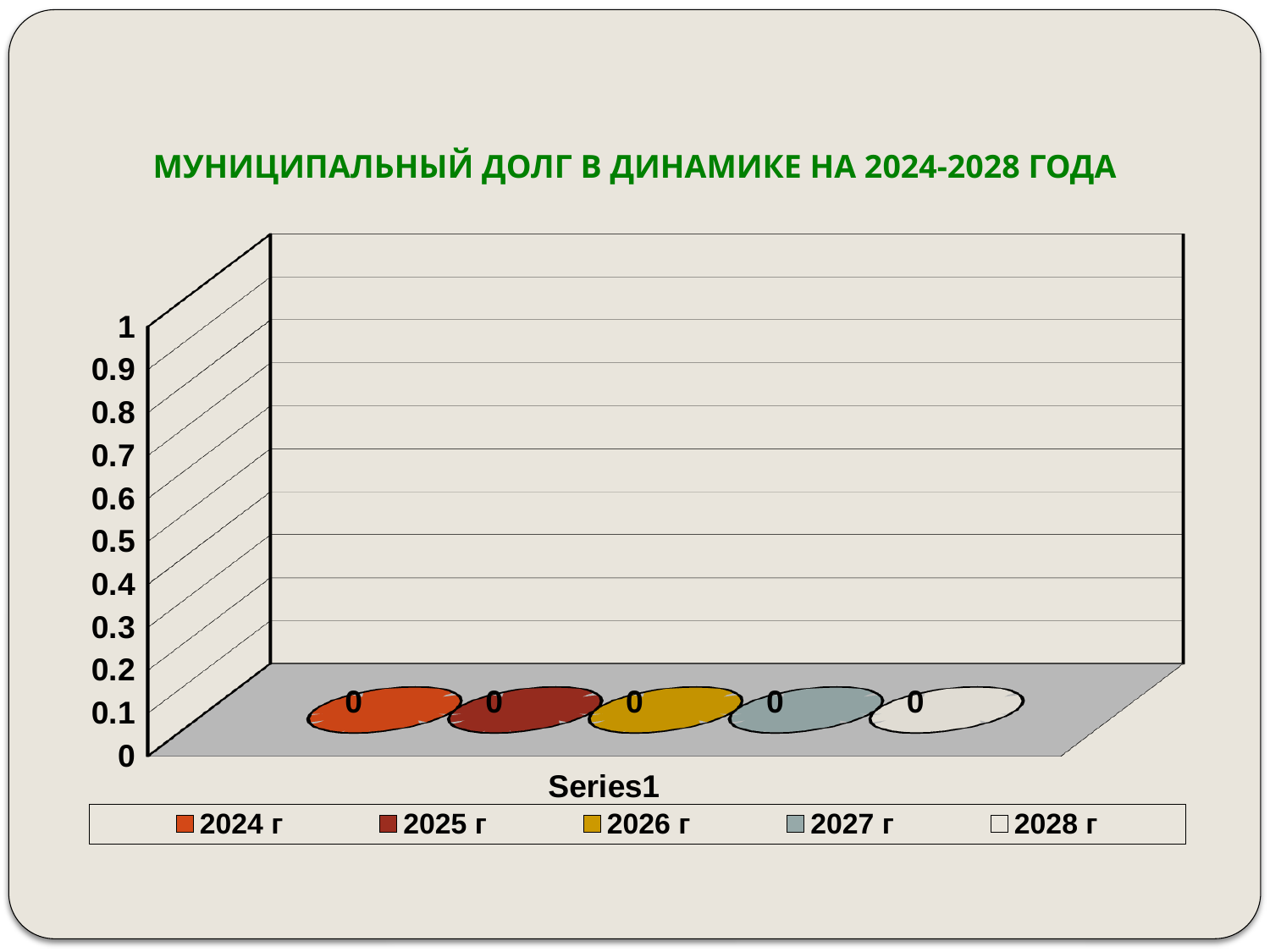
What is the value for 2025 г? 0 What is the value for 2026 г? 0 What is the value for 2028 г? 0 What kind of chart is shown on the slide? bar chart What is the difference between the values for 2024 г and 2028 г? 0 What is the value for 2024 г? 0 What is the value for 2027 г? 0 How many series does the legend list? 5 Do the values rise, fall or stay the same from 2024 г to 2028 г? stay the same What is the title of the chart? МУНИЦИПАЛЬНЫЙ ДОЛГ В ДИНАМИКЕ НА 2024-2028 ГОДА What is the highest value shown on the vertical axis? 1 Is the value for 2026 г greater or less than 0.5? less